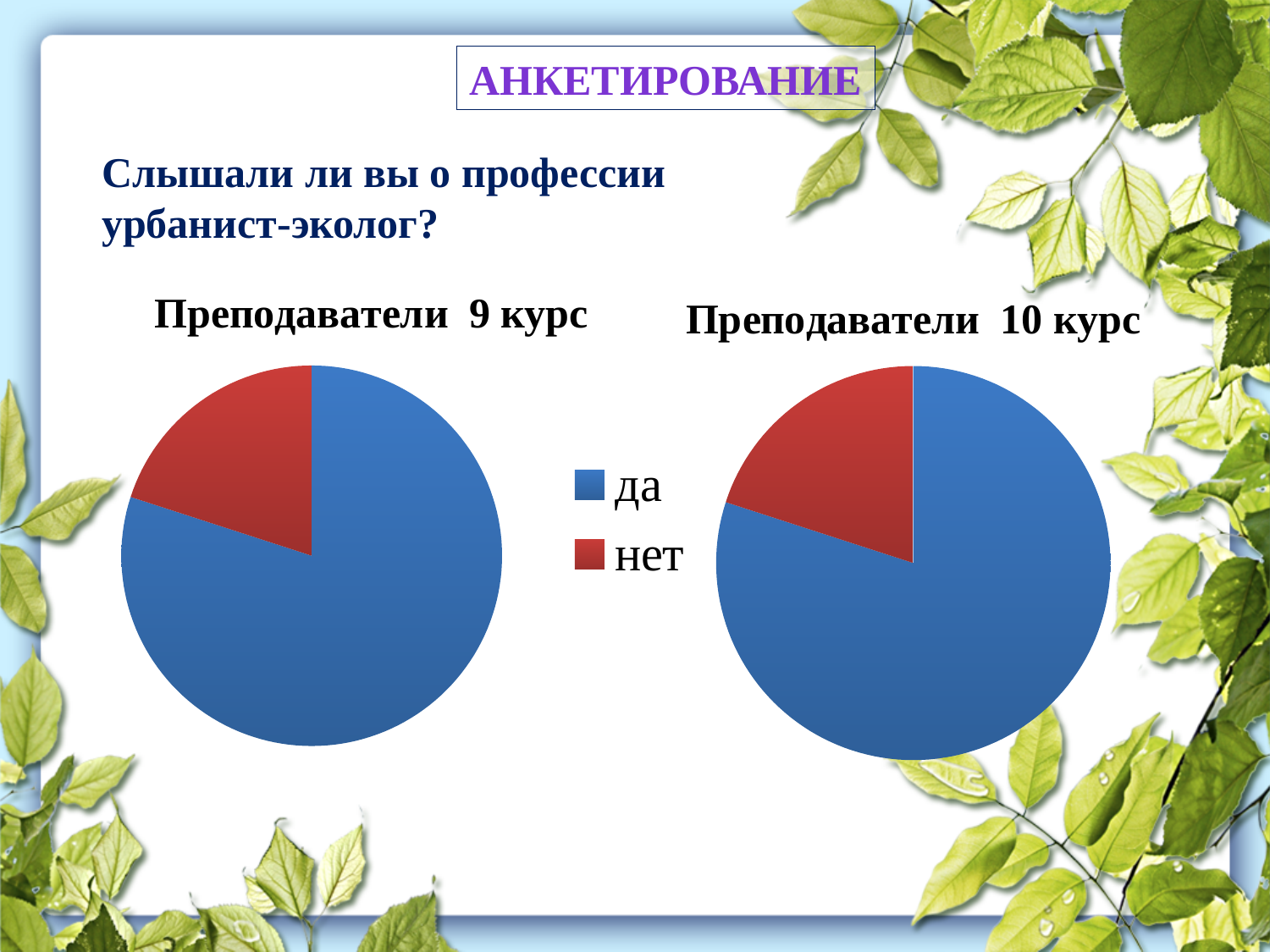
How many slices does the chart titled "Преподаватели 9 курс" have? 2 In the chart titled "Преподаватели 9 курс", which category has the smallest slice? нет How many entries does the legend shared by the two pie charts list? 2 What is the title of the pie chart on the right side of the slide? Преподаватели 10 курс In the chart titled "Преподаватели 10 курс", which category has the smallest slice? нет In the chart titled "Преподаватели 10 курс", which category has the largest slice? да In the chart titled "Преподаватели 10 курс", which slice is larger, "да" or "нет"? да What colour represents "нет" in the pie charts? red What kind of chart is the chart titled "Преподаватели 9 курс"? pie chart In the chart titled "Преподаватели 9 курс", which category has the largest slice? да In the chart titled "Преподаватели 9 курс", which slice is larger, "да" or "нет"? да What kind of chart is the chart titled "Преподаватели 10 курс"? pie chart